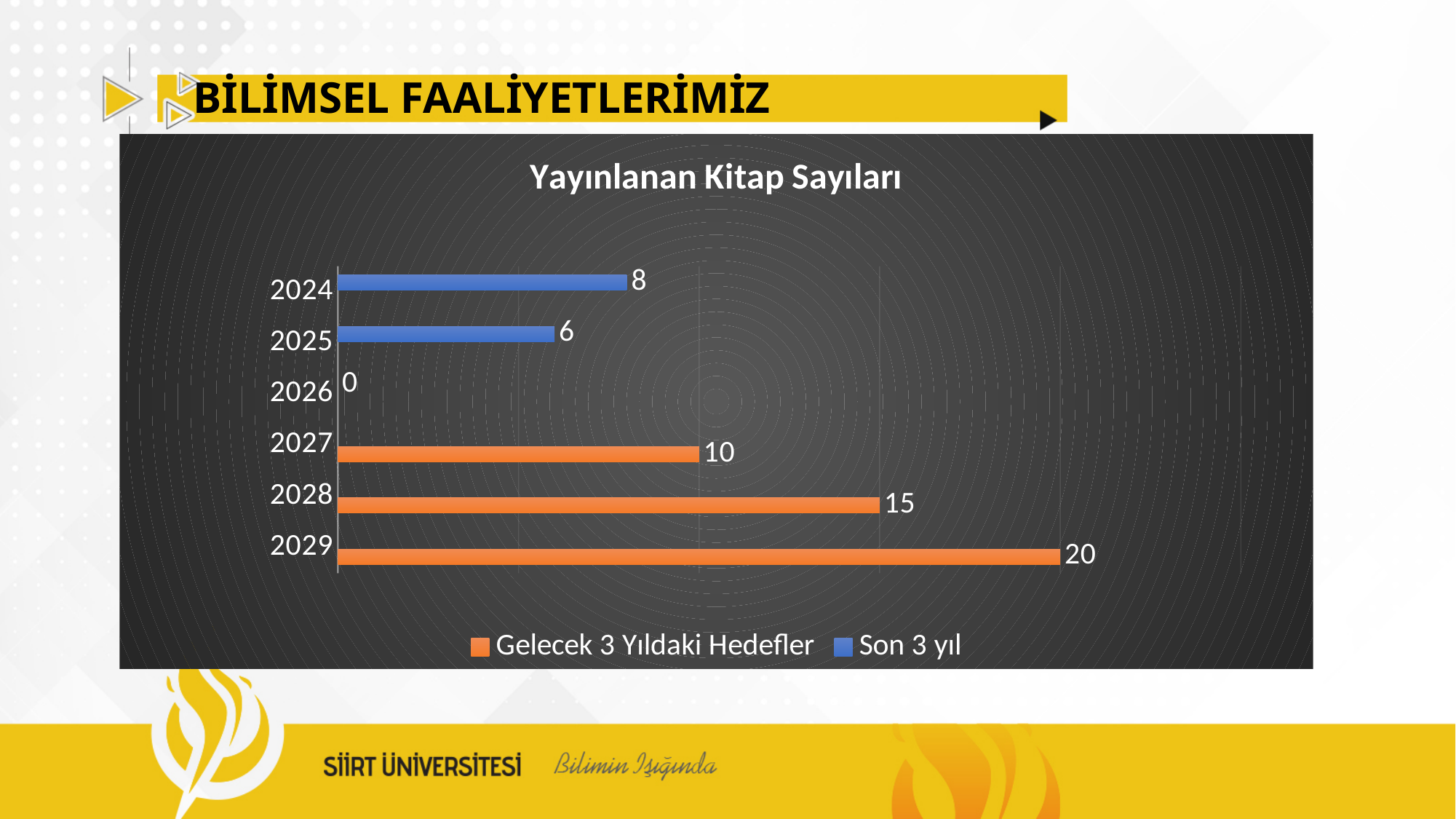
Which year has the highest value in the chart? 2029 What kind of chart is shown on the slide? Bar chart What is the value for 2024 in the chart? 8 How many series does the legend list? 2 What is the difference between the values for 2029 and 2027? 10 What is the value for 2028 in the chart? 15 Which is larger, the value for 2024 or the value for 2025? 2024 How many years are shown on the chart's axis? 6 What is the value for 2025 in the chart? 6 Which year has the lowest value in the chart? 2026 What is the title of the chart? Yayınlanan Kitap Sayıları What is the value for 2026 in the chart? 0